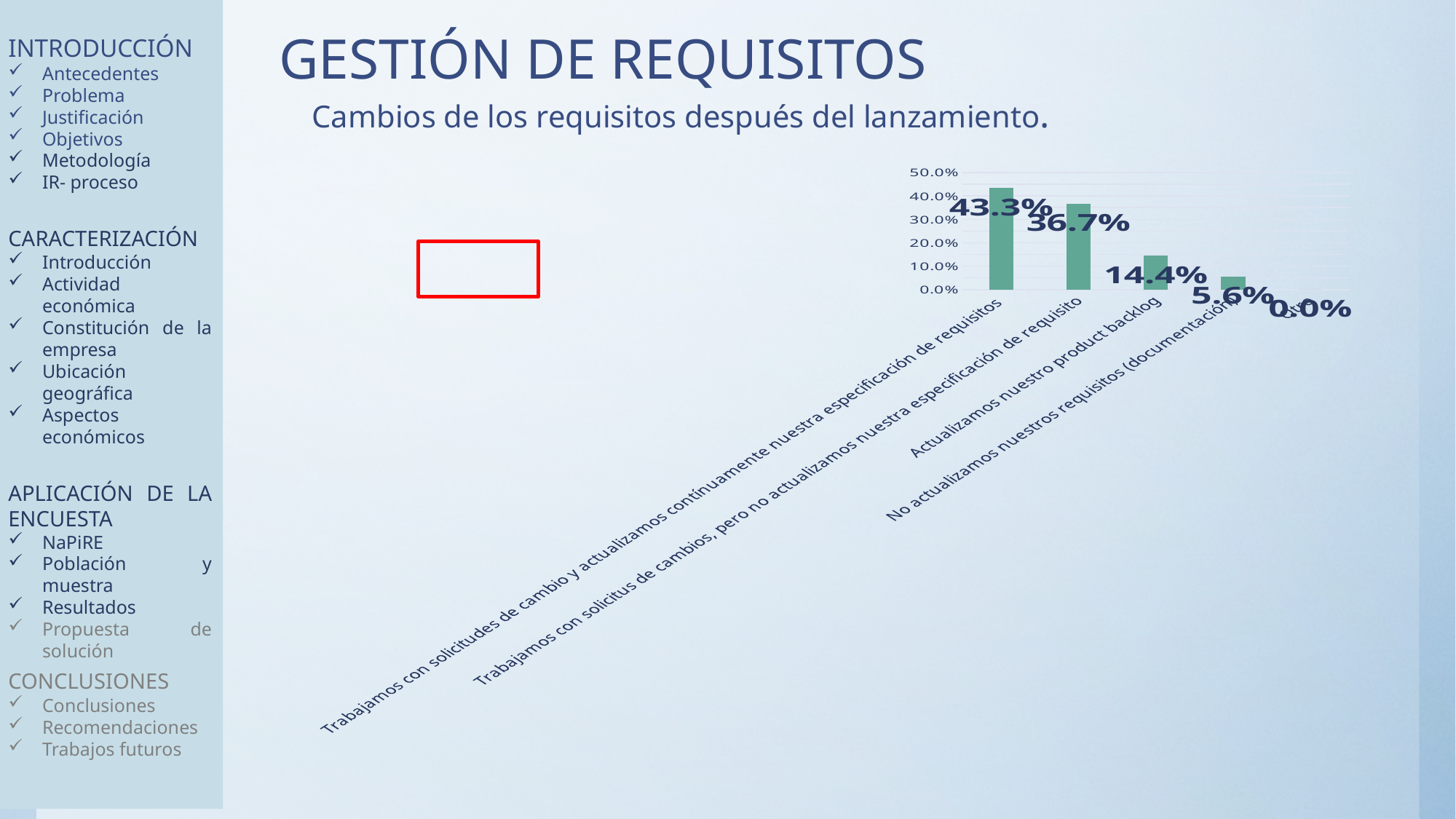
Is the value for "Actualizamos nuestro product backlog" greater or less than 20.0%? less What is the highest value shown on the y axis? 50.0% What is the value for "Trabajamos con solicitudes de cambio y actualizamos continuamente nuestra especificación de requisitos"? 43.3% What is the lowest data label shown on the chart? 0.0% What is the value for "Trabajamos con solicitus de cambios, pero no actualizamos nuestra especificación de requisito"? 36.7% Which category has the highest value? Trabajamos con solicitudes de cambio y actualizamos continuamente nuestra especificación de requisitos What is the value for "Actualizamos nuestro product backlog"? 14.4% How many bars are plotted in the chart? 5 Do the values rise or fall from left to right along the x axis? fall What is the difference between the values for "Trabajamos con solicitudes de cambio y actualizamos continuamente nuestra especificación de requisitos" and "Trabajamos con solicitus de cambios, pero no actualizamos nuestra especificación de requisito"? 6.6% Which is larger: the value for "Actualizamos nuestro product backlog" or the value for "Trabajamos con solicitus de cambios, pero no actualizamos nuestra especificación de requisito"? Trabajamos con solicitus de cambios, pero no actualizamos nuestra especificación de requisito What kind of chart is shown on the slide? bar chart